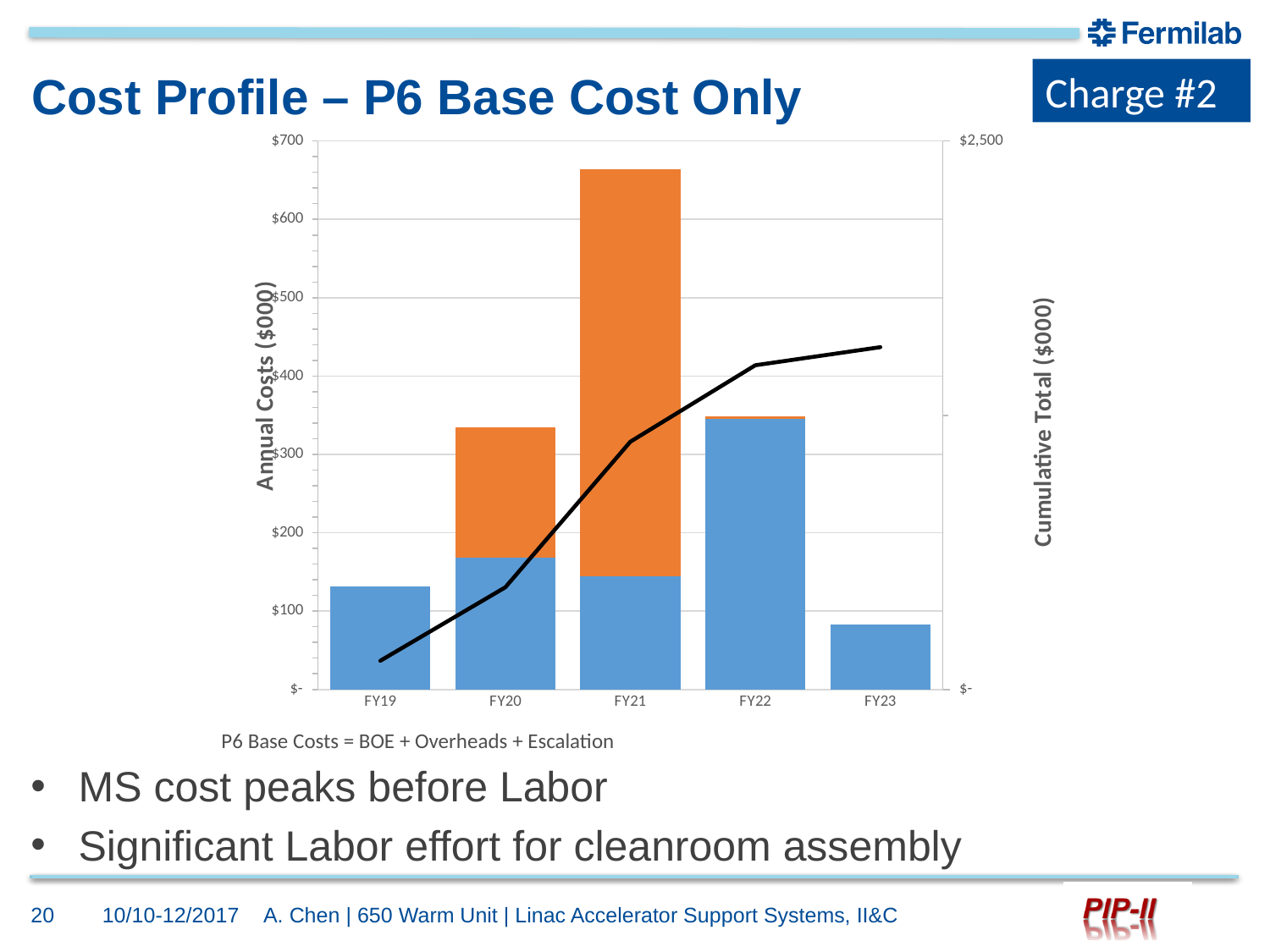
Is the total stacked bar for FY23 greater or less than $100? less Is the total stacked bar for FY22 greater or less than $300? greater Which fiscal year has the tallest stacked bar? FY21 How many fiscal years are shown on the x axis of the chart? 5 What is the title of the left vertical axis? Annual Costs ($000) Which stacked bar is taller, FY20 or FY19? FY20 Is the total stacked bar for FY21 greater or less than $600? greater Which fiscal year has the shortest stacked bar? FY23 What is the title of the right vertical axis? Cumulative Total ($000) Does the black cumulative total line rise or fall from FY19 to FY23? Rises What kind of chart is shown on the slide? Stacked bar chart with a line